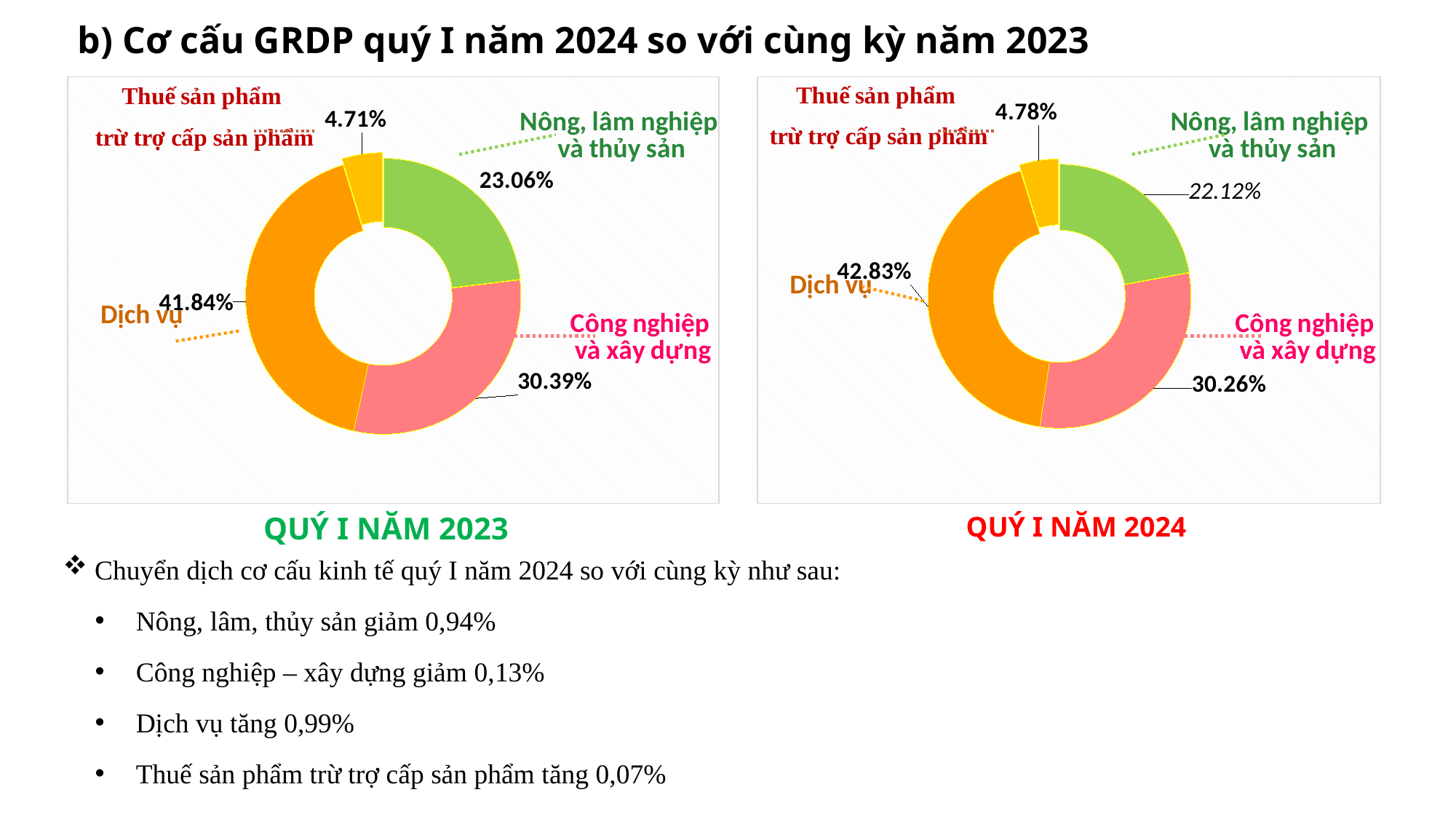
What kind of chart is the QUÝ I NĂM 2024 chart? Doughnut chart Which is larger: the Dịch vụ share in the QUÝ I NĂM 2023 chart or the Dịch vụ share in the QUÝ I NĂM 2024 chart? QUÝ I NĂM 2024 In the QUÝ I NĂM 2024 chart, which category has the smallest share? Thuế sản phẩm trừ trợ cấp sản phẩm In the QUÝ I NĂM 2023 chart, what share does Dịch vụ have? 41.84% In the QUÝ I NĂM 2023 chart, which is larger: Nông, lâm nghiệp và thủy sản or Công nghiệp và xây dựng? Công nghiệp và xây dựng In the QUÝ I NĂM 2023 chart, what share does Công nghiệp và xây dựng have? 30.39% In the QUÝ I NĂM 2023 chart, which category has the largest share? Dịch vụ How many categories does the QUÝ I NĂM 2023 chart show? 4 In the QUÝ I NĂM 2024 chart, what share does Thuế sản phẩm trừ trợ cấp sản phẩm have? 4.78% In the QUÝ I NĂM 2024 chart, what is the difference between the Dịch vụ share and the Công nghiệp và xây dựng share? 12.57% In the QUÝ I NĂM 2024 chart, what share does Nông, lâm nghiệp và thủy sản have? 22.12% In the QUÝ I NĂM 2023 chart, what colour is the Dịch vụ segment? Orange